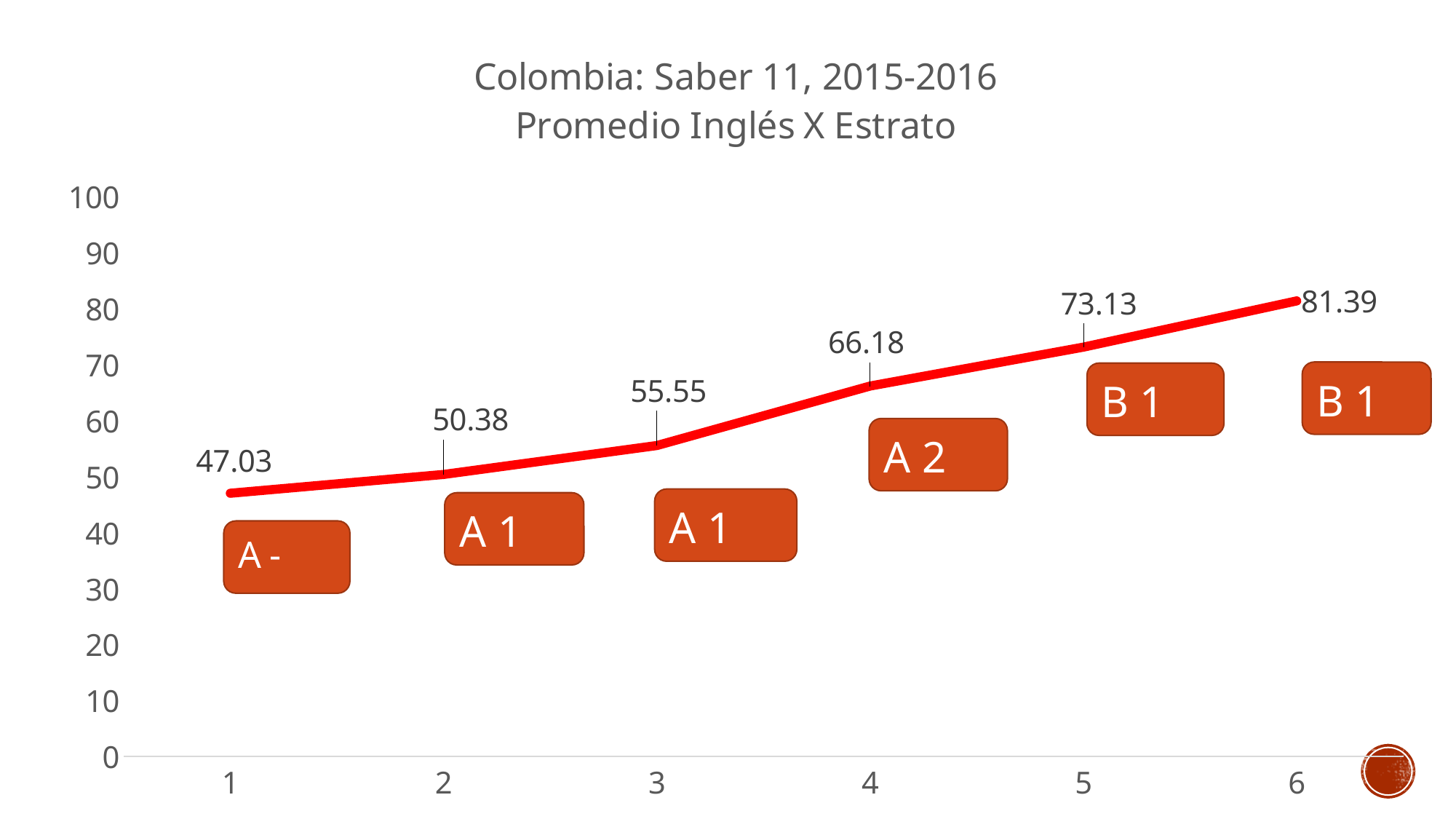
Which estrato has the highest average English score? 6 Do the values rise or fall as the estrato increases from 1 to 6? rise What is the difference between the scores for estrato 6 and estrato 1? 34.36 What is the average English score for estrato 4? 66.18 Is the value for estrato 5 greater or less than 70? greater Which is larger, the score for estrato 3 or estrato 2? estrato 3 How many estratos are plotted on the chart? 6 Which estrato has the lowest average English score? 1 What kind of chart is shown on the slide? line chart What is the difference between the scores for estrato 5 and estrato 4? 6.95 What is the average English score for estrato 6? 81.39 What is the average English score for estrato 1? 47.03